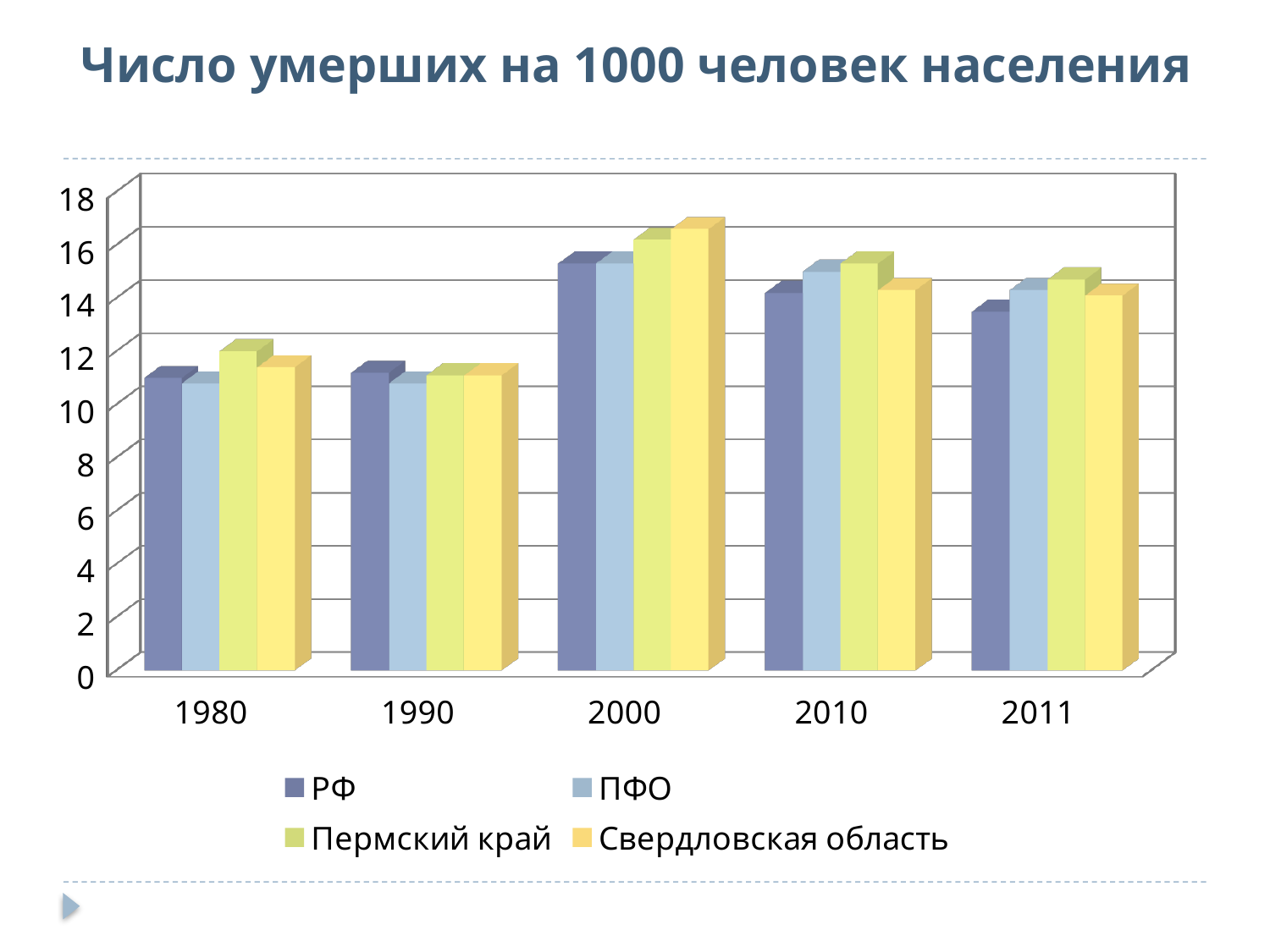
Is the value for Свердловская область in 2000 greater or less than 16? greater Is the value for ПФО in 1980 greater or less than 12? less Is the value for РФ in 2011 greater or less than 12? greater What kind of chart is shown on the slide? bar chart In which year is the value for Пермский край the highest? 2000 Which series is shown in yellow in the chart legend? Свердловская область How many years are shown on the x axis of the chart? 5 In which year is the value for РФ the highest? 2000 How many series does the chart legend list? 4 What is the title of the chart? Число умерших на 1000 человек населения Which is larger in 2010: the value for Пермский край or the value for РФ? Пермский край Which is larger for РФ: the value in 2000 or the value in 1990? 2000